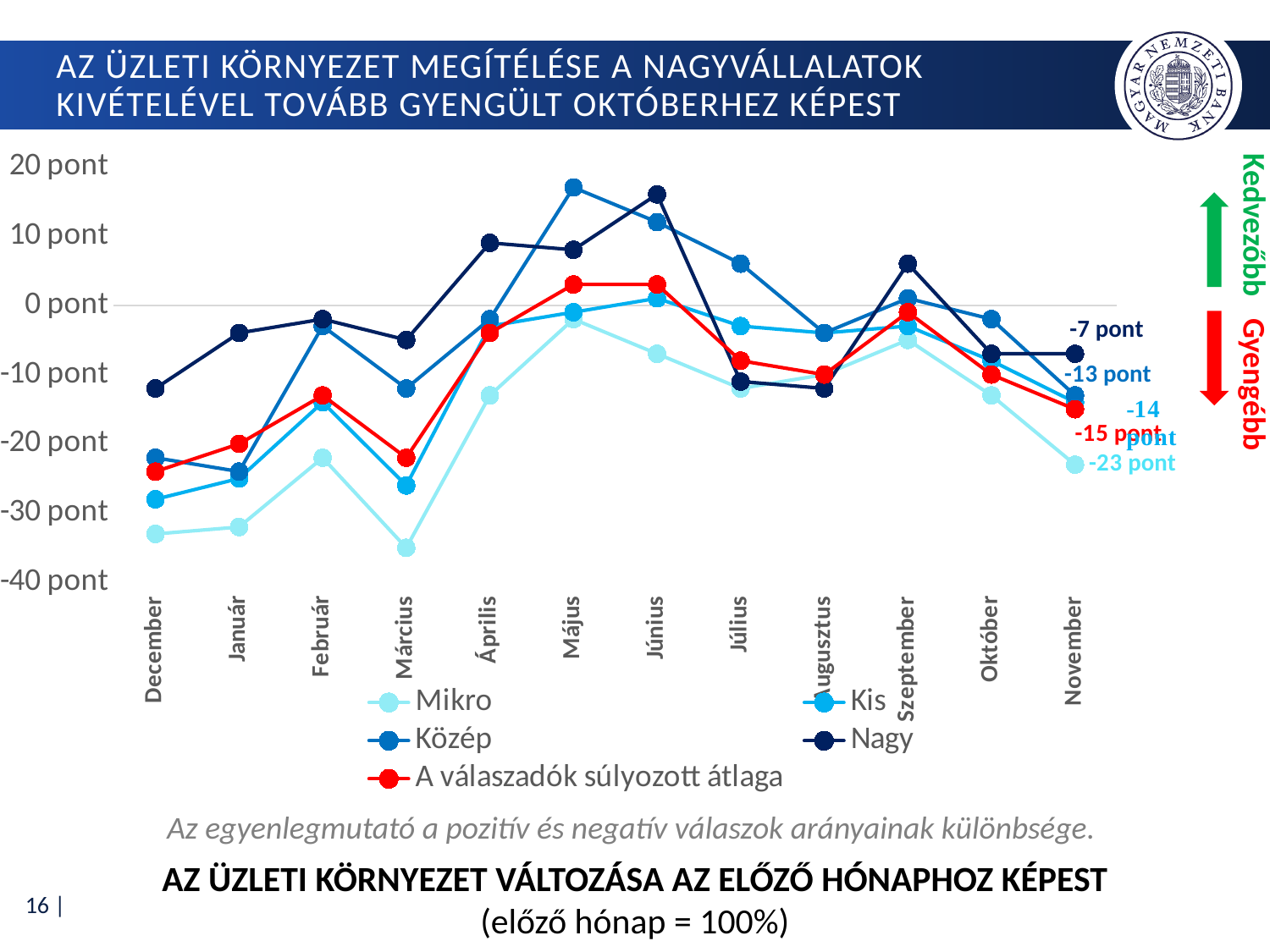
What is the value for Mikro in November? -23 pont What is the value for Nagy in November? -7 pont How many series does the legend list? 5 What is the value for Közép in November? -13 pont What is the value for A válaszadók súlyozott átlaga in November? -15 pont How many months are shown on the x axis? 12 Which series has the highest value in November? Nagy Is the value for Közép in Május greater or less than 10 pont? greater In November, which is larger: the value for Kis or the value for Közép? Közép What is the difference between the November values of Nagy and Mikro? 16 pont Is the value for Mikro in Március greater or less than -30 pont? less Which series has the lowest value in November? Mikro